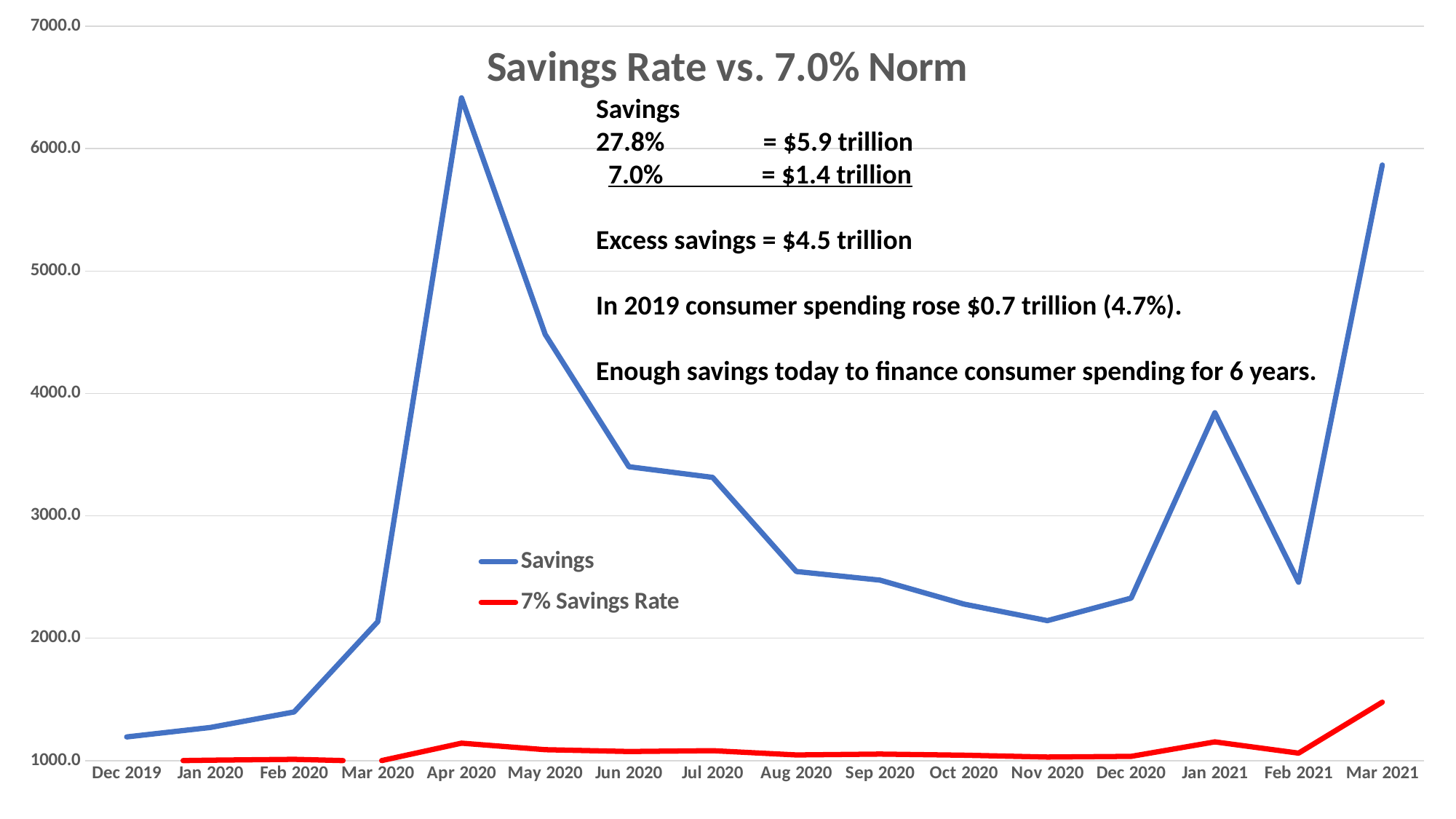
Which series is drawn in red? 7% Savings Rate Is the Savings value for Apr 2020 greater or less than 6000? greater Does the Savings series rise or fall from Apr 2020 to Nov 2020? fall In which month is the Savings series at its lowest value? Dec 2019 How many series does the legend list? 2 In which month does the Savings series reach its highest value? Apr 2020 Is the Savings value for Jun 2020 greater or less than 3000? greater What kind of chart is shown on the slide? line chart What is the title of the chart? Savings Rate vs. 7.0% Norm Which is larger for the Savings series, Jan 2021 or Feb 2021? Jan 2021 How many months are shown along the x axis? 16 Is the Savings value for Aug 2020 greater or less than 3000? less